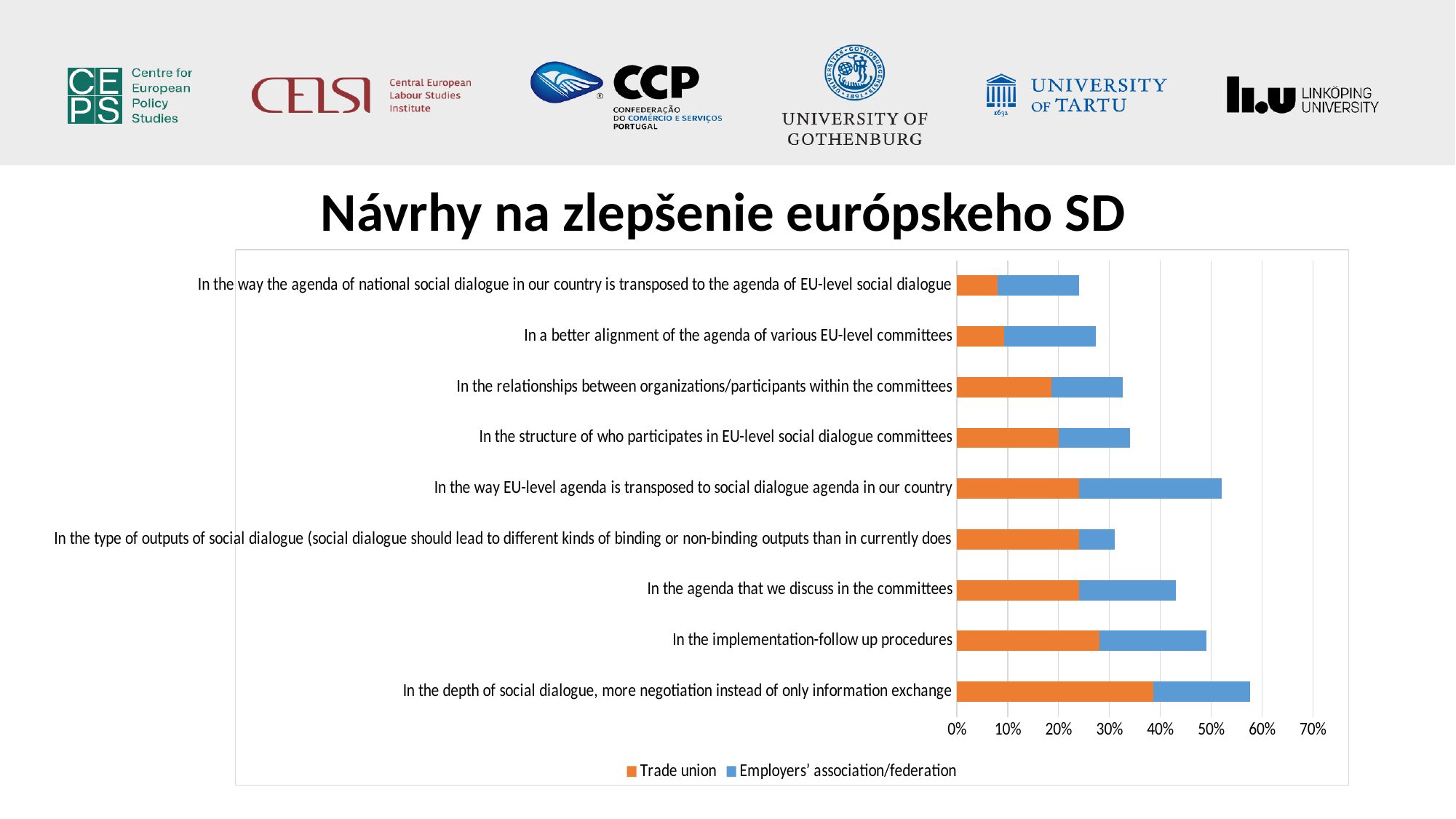
Is the total bar for 'In the depth of social dialogue, more negotiation instead of only information exchange' greater or less than 50%? greater Is the Trade union value for 'In the depth of social dialogue, more negotiation instead of only information exchange' greater or less than 30%? greater Which category has the shortest total bar? In the way the agenda of national social dialogue in our country is transposed to the agenda of EU-level social dialogue Which category has the longest total bar? In the depth of social dialogue, more negotiation instead of only information exchange How many categories (proposals) are listed on the chart? 9 Is the total bar for 'In the way the agenda of national social dialogue in our country is transposed to the agenda of EU-level social dialogue' greater or less than 30%? less Which colour represents the Trade union series in the chart? Orange What kind of chart is shown on the slide? Stacked bar chart How many series does the chart legend list? 2 Which has the longer total bar: 'In the implementation-follow up procedures' or 'In the agenda that we discuss in the committees'? In the implementation-follow up procedures